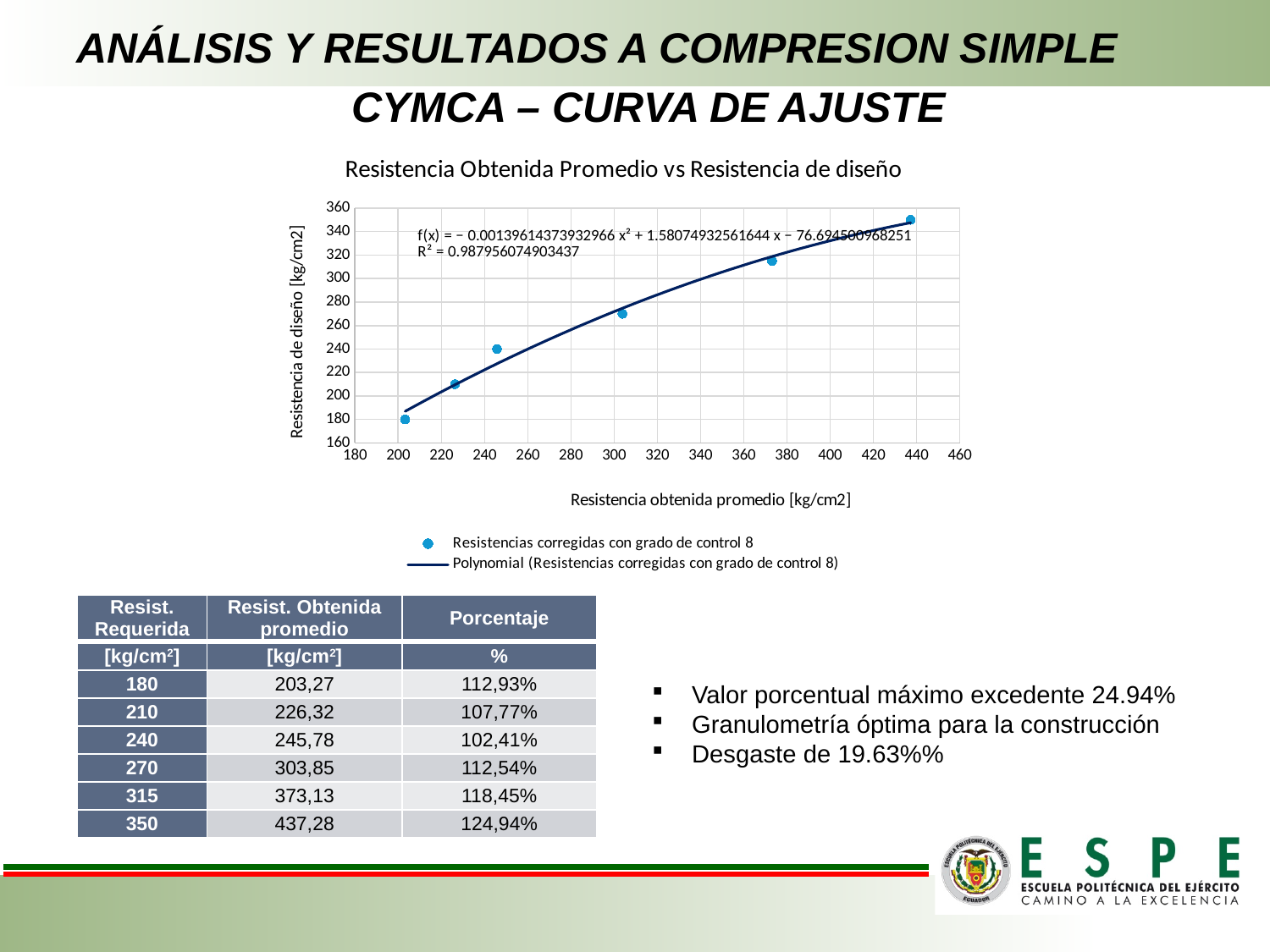
What is the y-axis value of the leftmost data point in the chart? 180 How many data points are plotted in the chart? 6 Is the y-axis value of the data point near x = 300 greater or less than 260? greater Is the y-axis value of the rightmost data point greater or less than 340? greater What is the x-axis title of the chart? Resistencia obtenida promedio [kg/cm2] Do the plotted values rise or fall as the x-axis value increases? Rise How many entries does the chart legend list? 2 What kind of chart is shown on the slide? Scatter chart with a polynomial trendline What R² value is printed on the chart? R² = 0.987956074903437 Which data point has the highest y-axis value, the leftmost or the rightmost? The rightmost Is the y-axis value of the leftmost data point greater or less than 200? less What is the title of the chart? Resistencia Obtenida Promedio vs Resistencia de diseño